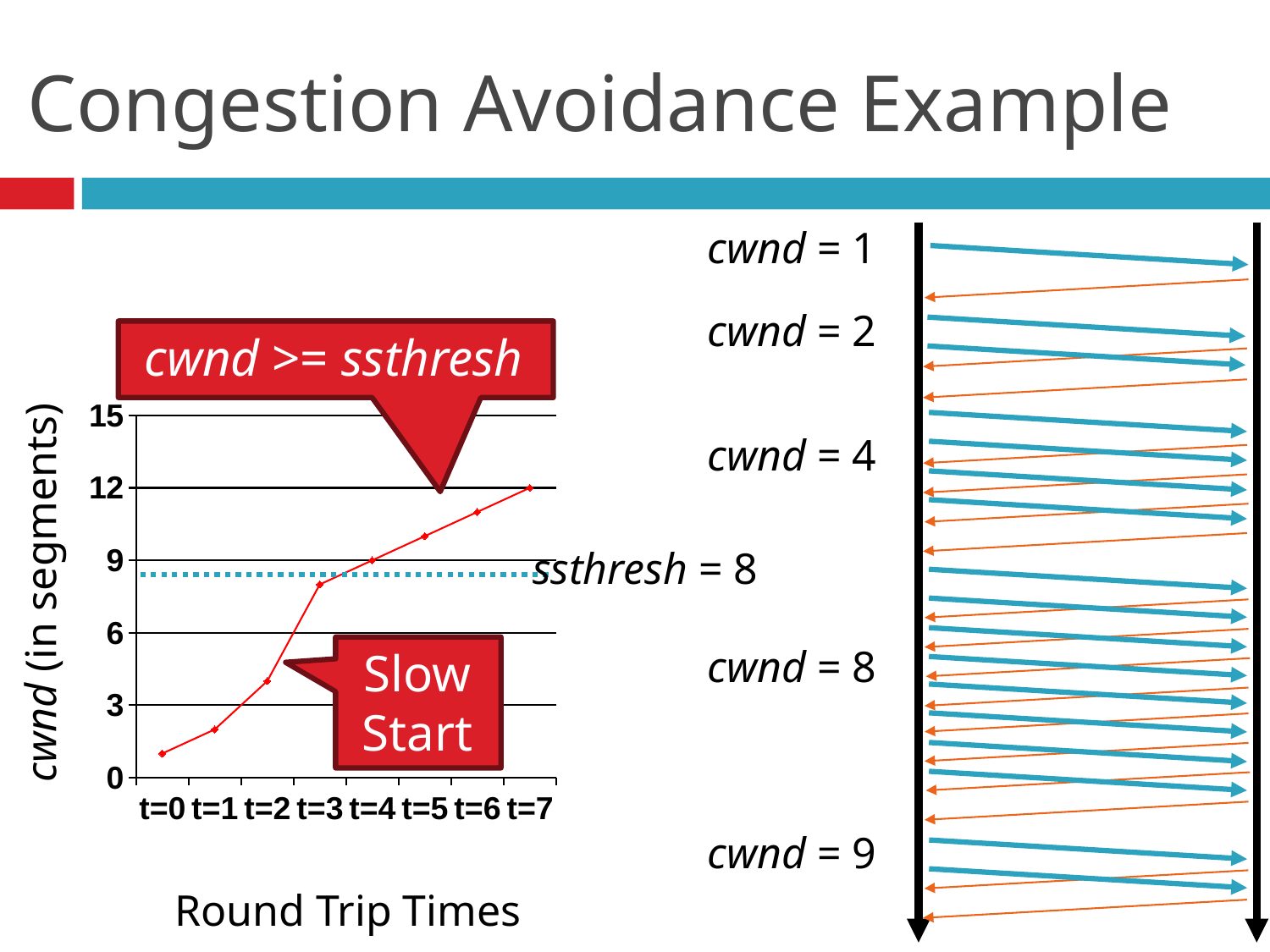
What is the title of the chart's x axis? Round Trip Times What is the cwnd value at t=7? 12 What is the cwnd value at t=4? 9 At which round trip time is cwnd highest? t=7 Is the cwnd value at t=6 greater or less than 12? less Is the cwnd value at t=5 greater or less than 9? greater At which round trip time is cwnd lowest? t=0 Is the cwnd value at t=0 greater or less than 3? less How many data points are plotted on the chart? 8 What kind of chart is shown on the slide? line chart Does cwnd rise or fall from t=0 to t=7? rise Which has a larger cwnd value, t=2 or t=3? t=3